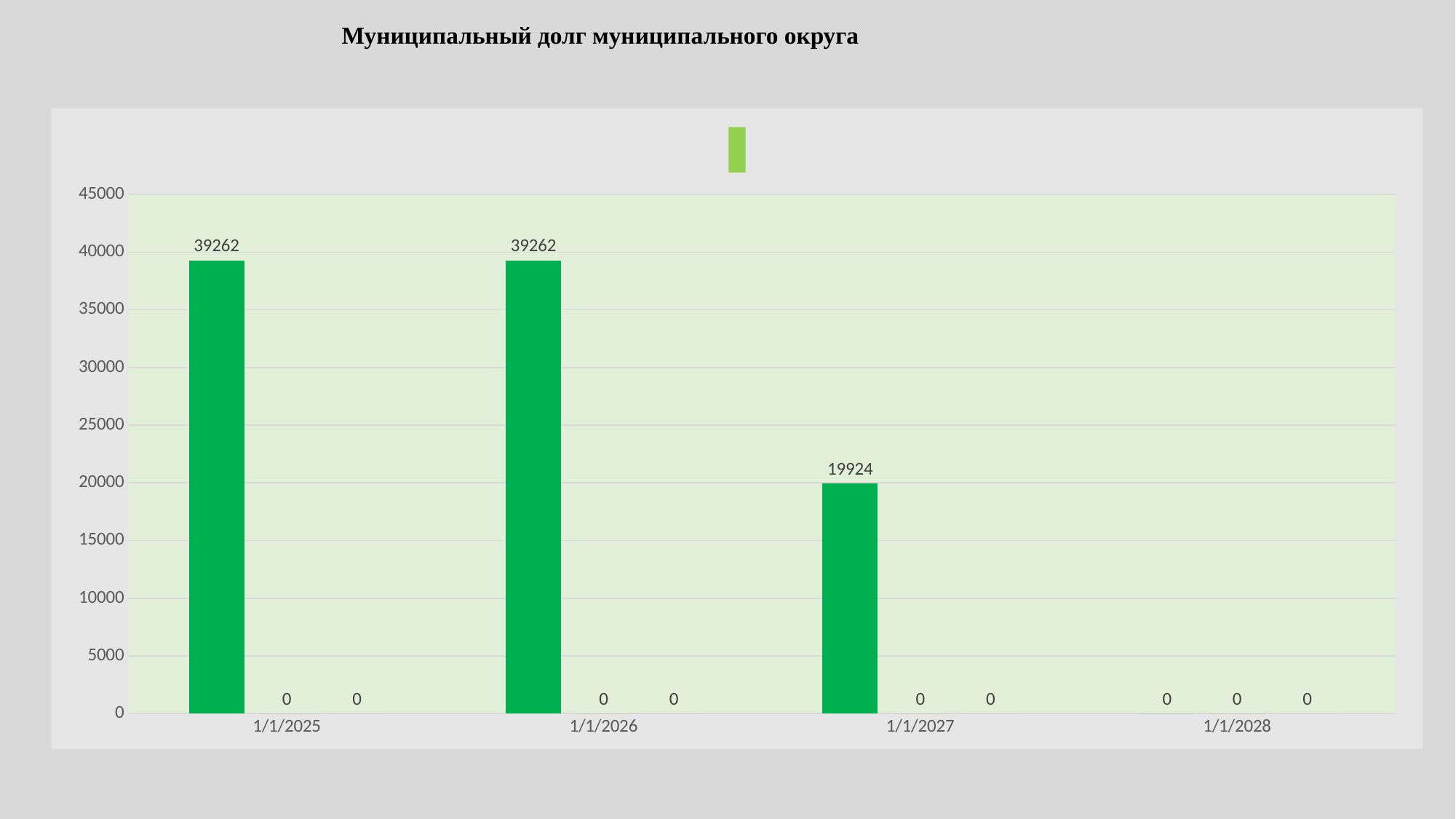
What is the value of the green bar for 1/1/2027? 19924 Which is larger, the green bar for 1/1/2026 or for 1/1/2027? 1/1/2026 Is the value of the green bar for 1/1/2025 greater or less than 35000? greater How many dates are shown on the x axis? 4 What is the difference between the green bar values for 1/1/2026 and 1/1/2027? 19338 What kind of chart is shown on the slide? bar chart Which date has the lowest value for the green bars? 1/1/2028 Do the green bar values rise or fall from 1/1/2025 to 1/1/2028? fall What is the value of the green bar for 1/1/2026? 39262 What is the value of the green bar for 1/1/2025? 39262 What is the title of the chart? Муниципальный долг муниципального округа What value is shown for 1/1/2028? 0